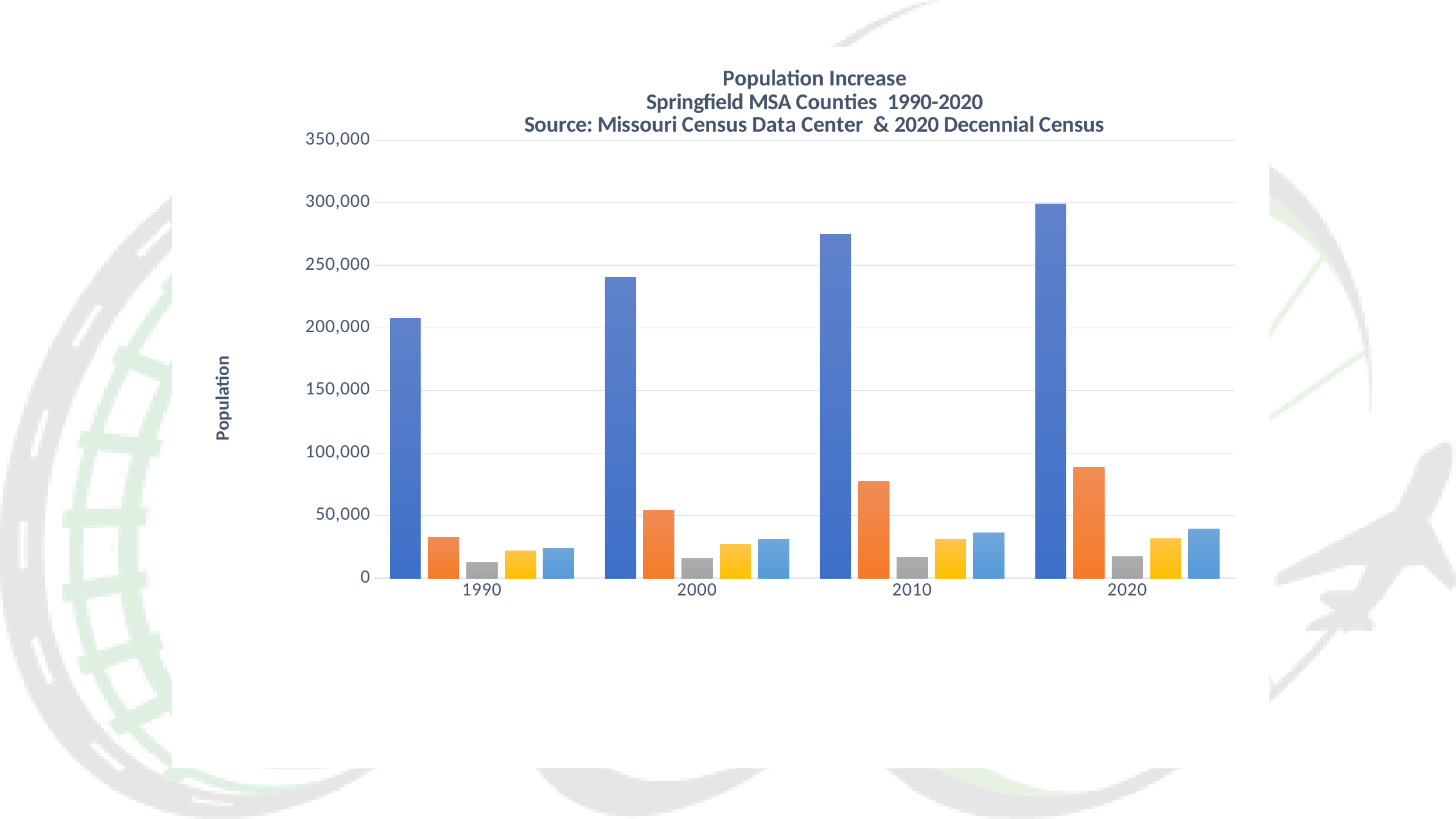
Is the value of the dark blue bar for 2020 greater or less than 250,000? greater Is the value of the dark blue bar for 2000 greater or less than 200,000? greater How many years are shown along the x axis of the chart? 4 Which year has the shortest dark blue bar? 1990 How many bars are plotted for each year on the chart? 5 What kind of chart is shown on the slide? bar chart Do the dark blue bars rise or fall from 1990 to 2020? rise In 2020, which is taller: the orange bar or the light blue bar? the orange bar What is the label on the vertical axis of the chart? Population Which year has the tallest dark blue bar? 2020 Is the value of the dark blue bar for 1990 greater or less than 250,000? less